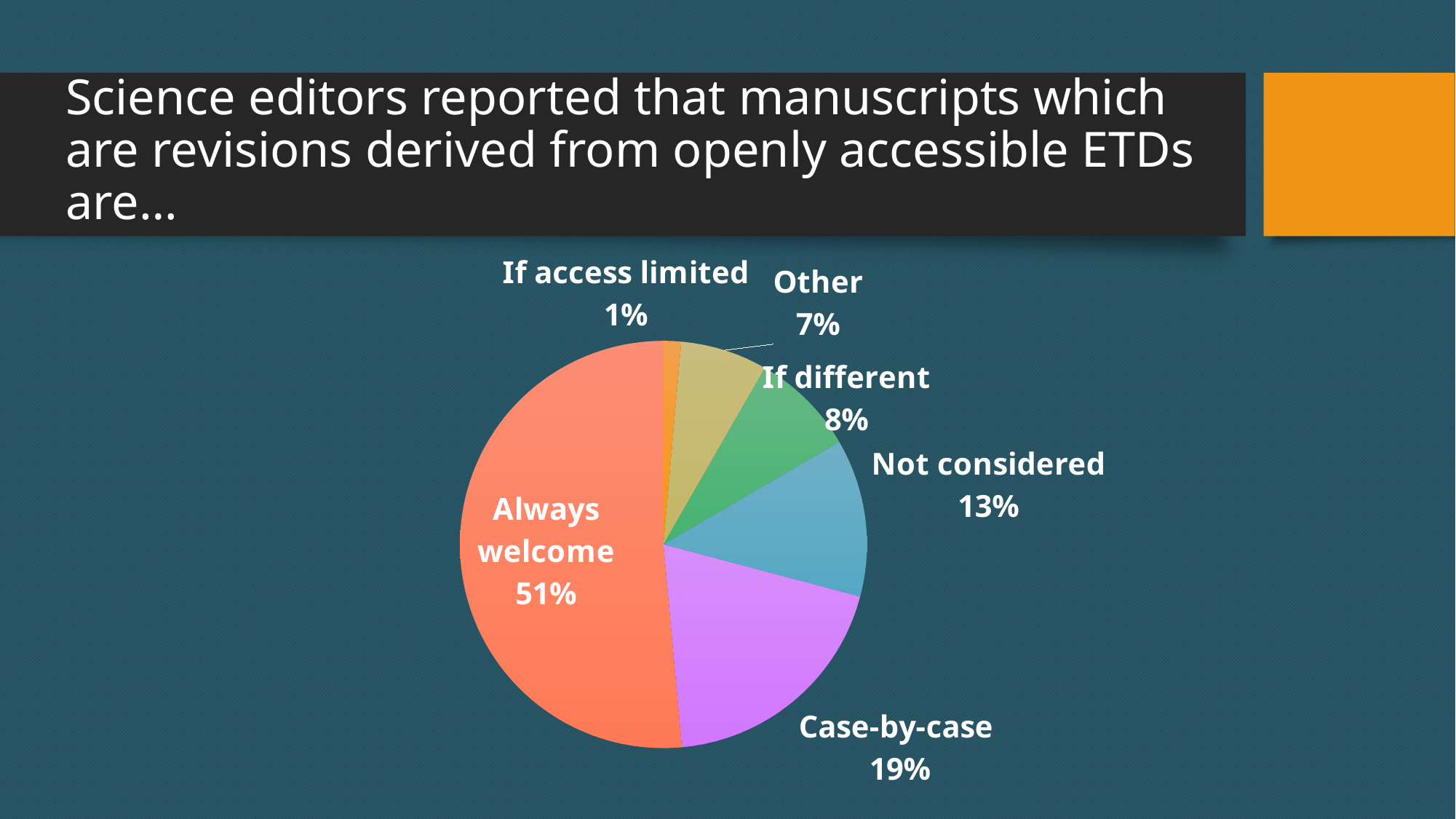
What is the difference in percentage points between Case-by-case and Not considered? 6 How many categories are shown in the pie chart? 6 Which category has the smallest slice of the pie? If access limited What percentage is shown for the Case-by-case slice? 19% Which is larger, the Other slice or the If different slice? If different What colour is the Always welcome slice? orange-red (salmon) What percentage is shown for the Not considered slice? 13% What kind of chart is shown on the slide? pie chart What percentage is shown for the If different slice? 8% Which category has the largest slice of the pie? Always welcome What percentage is shown for the If access limited slice? 1% What share of science editors reported that manuscripts derived from openly accessible ETDs are always welcome? 51%